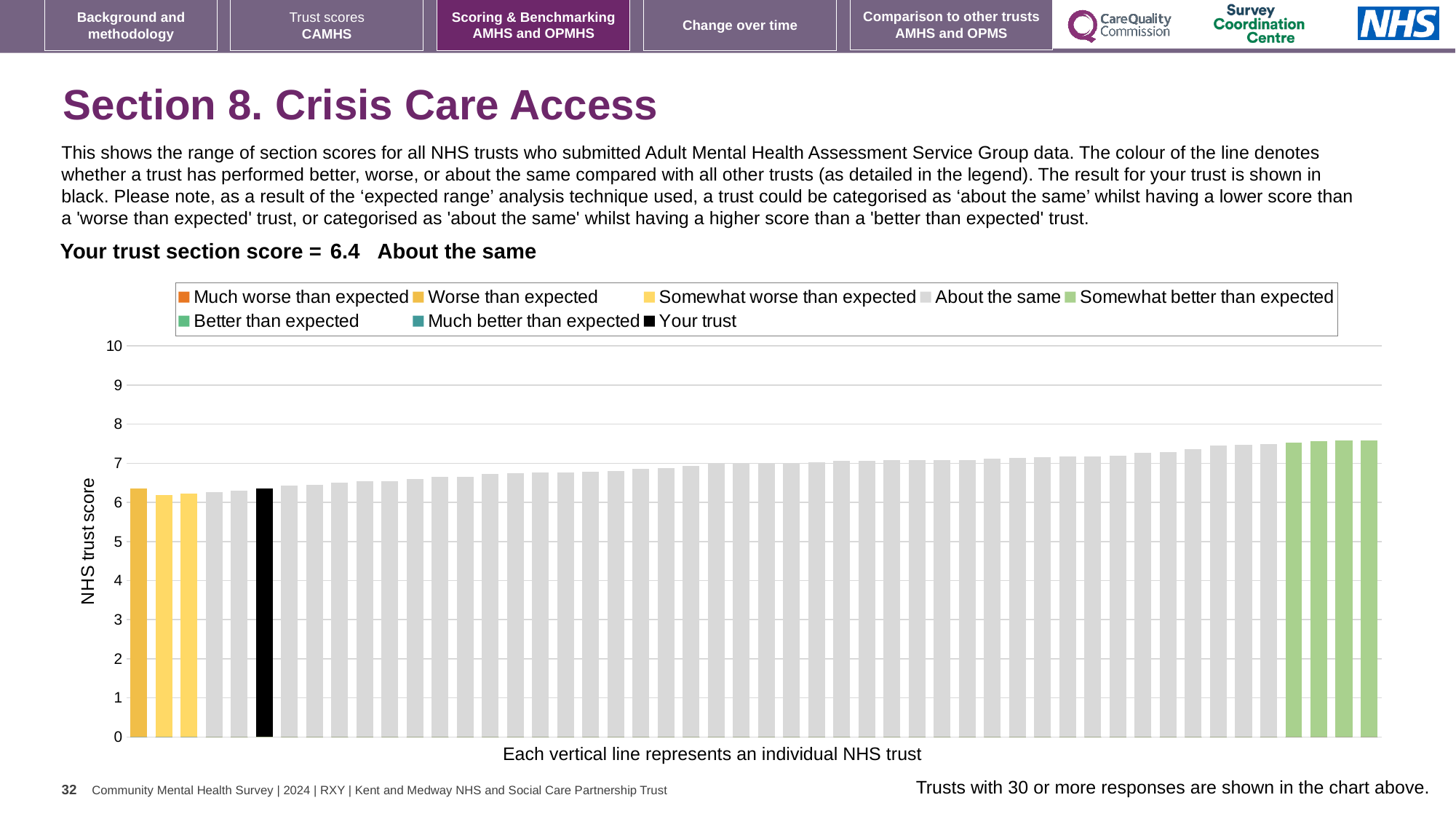
Is the value for the shortest bar in the chart greater or less than 6? greater Which performance category does the highest-scoring trust (rightmost bar) belong to? Somewhat better than expected Is the value for the tallest bar in the chart greater or less than 7? greater Is the value for your trust (the black bar) greater or less than 7? less What is the section score for your trust shown on the slide? 6.4 How many entries does the chart legend list? 8 How many bars are coloured green (Somewhat better than expected)? 4 What kind of chart is shown on the slide? bar chart Which performance category is your trust placed in for Crisis Care Access? About the same Do the bar values rise or fall moving from left to right along the x axis? rise What is the label on the vertical axis of the chart? NHS trust score